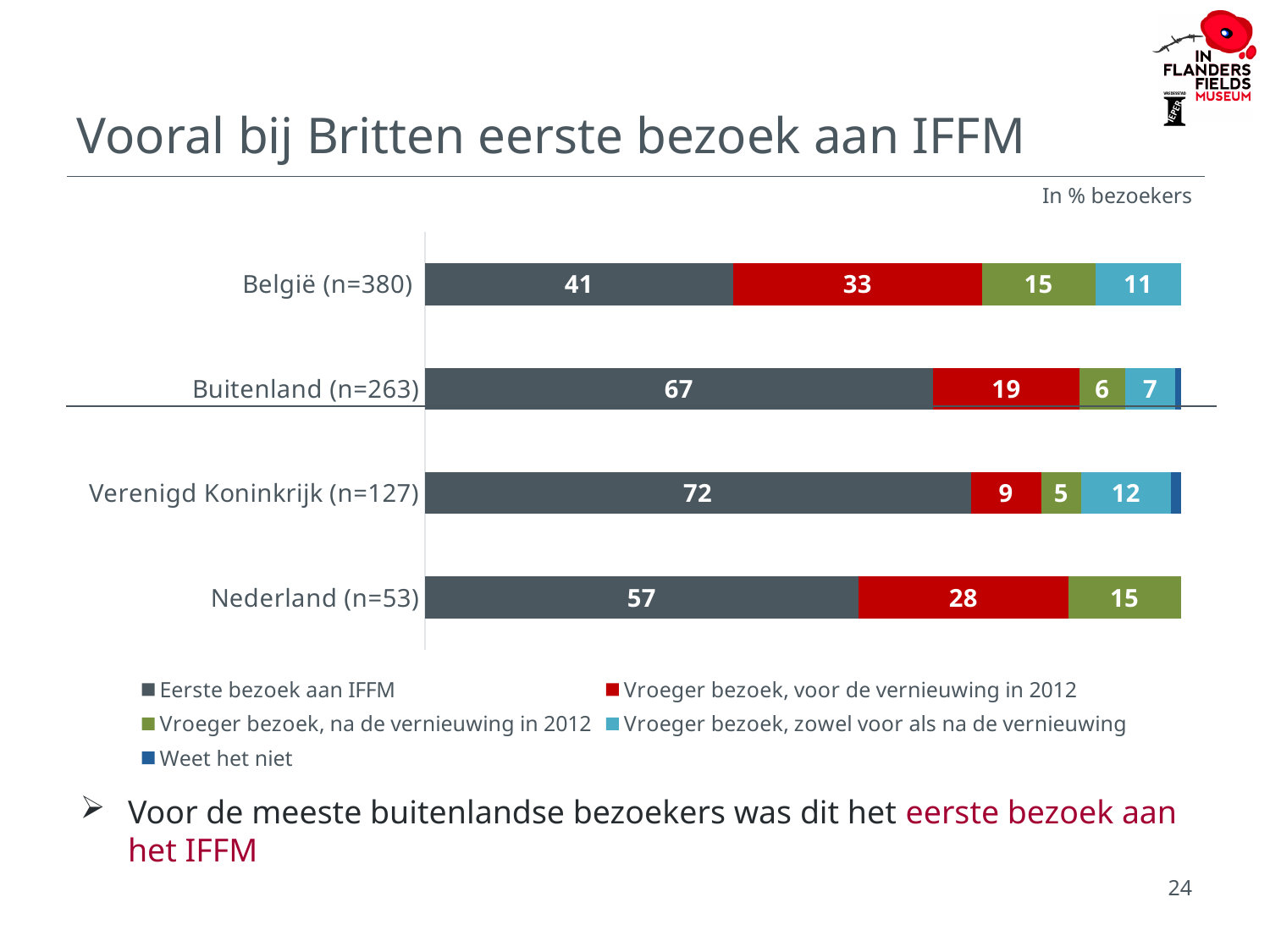
What unit is the chart expressed in, according to the note above the chart? In % bezoekers What is the value of 'Vroeger bezoek, voor de vernieuwing in 2012' for België (n=380)? 33 What is the value of 'Vroeger bezoek, zowel voor als na de vernieuwing' for Buitenland (n=263)? 7 What is the value of 'Eerste bezoek aan IFFM' for Verenigd Koninkrijk (n=127)? 72 What is the difference between the 'Eerste bezoek aan IFFM' values for Verenigd Koninkrijk (n=127) and België (n=380)? 31 Which category has the lowest value for 'Eerste bezoek aan IFFM'? België (n=380) What kind of chart is shown on the slide? Stacked bar chart Which is larger: the 'Vroeger bezoek, voor de vernieuwing in 2012' value for Nederland (n=53) or for Buitenland (n=263)? Nederland (n=53) What is the value of 'Vroeger bezoek, na de vernieuwing in 2012' for Nederland (n=53)? 15 How many series does the legend list? 5 How many categories (countries/groups) are shown on the chart? 4 Which category has the highest value for 'Eerste bezoek aan IFFM'? Verenigd Koninkrijk (n=127)